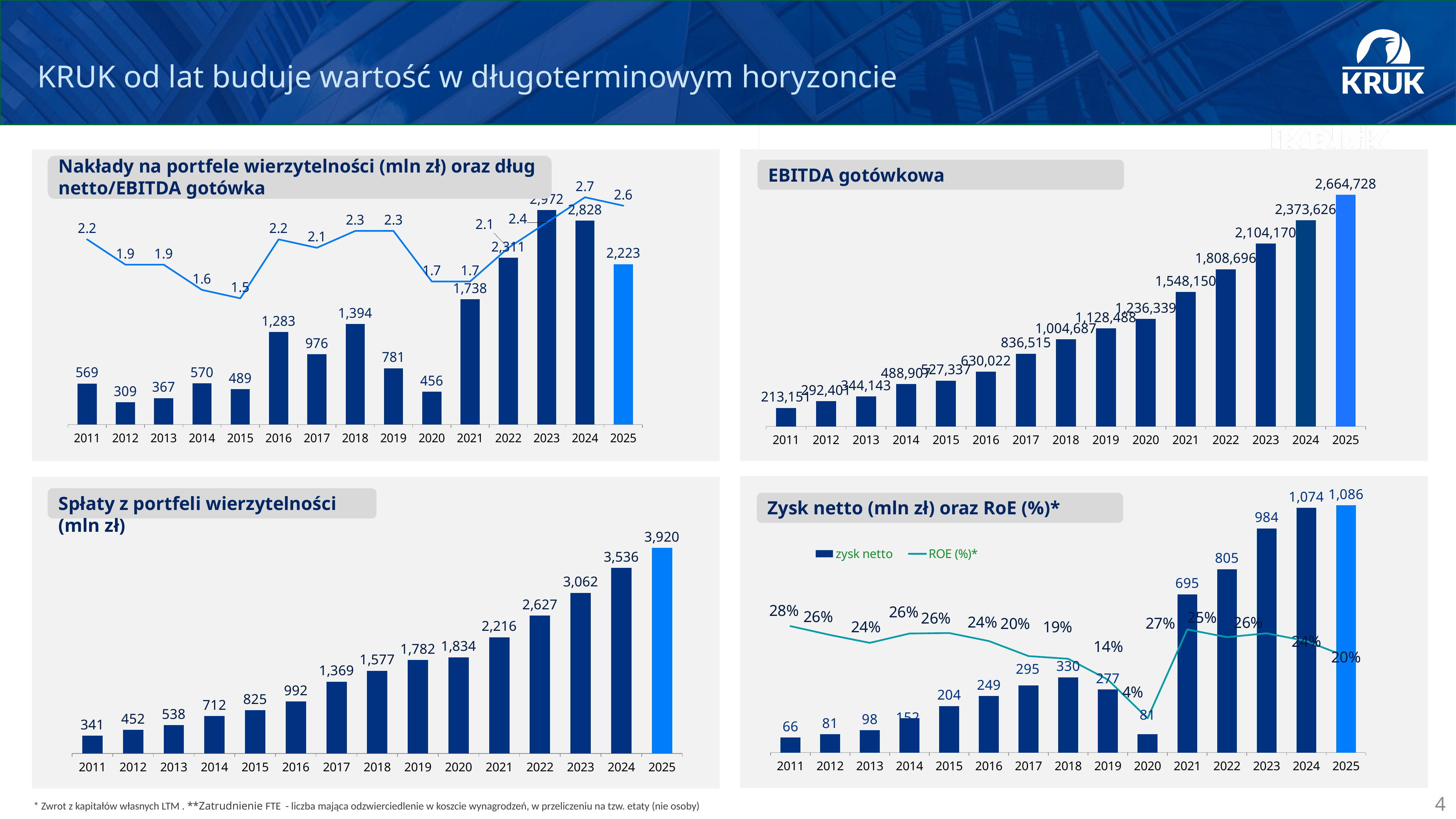
How many series does the legend of the 'Zysk netto (mln zł) oraz RoE (%)*' chart list? 2 In the 'Zysk netto (mln zł) oraz RoE (%)*' chart, what is the ROE (%)* value for 2020? 4% In the 'Nakłady na portfele wierzytelności (mln zł) oraz dług netto/EBITDA gotówka' chart, what is the bar value for 2016? 1,283 What kind of chart is the 'Spłaty z portfeli wierzytelności (mln zł)' chart? bar chart In the 'Nakłady na portfele wierzytelności (mln zł) oraz dług netto/EBITDA gotówka' chart, which year has the highest bar value? 2023 In the 'Spłaty z portfeli wierzytelności (mln zł)' chart, what is the value for 2025? 3,920 In the 'EBITDA gotówkowa' chart, what is the value for 2018? 1,004,687 In the 'Zysk netto (mln zł) oraz RoE (%)*' chart, which year has the lowest zysk netto value? 2011 In the 'EBITDA gotówkowa' chart, do the values rise or fall from 2011 to 2025? rise In the 'Spłaty z portfeli wierzytelności (mln zł)' chart, what is the difference between the values for 2025 and 2024? 384 In the 'Zysk netto (mln zł) oraz RoE (%)*' chart, which is larger: the zysk netto value for 2018 or for 2019? 2018 How many years are shown on the x axis of the 'EBITDA gotówkowa' chart? 15